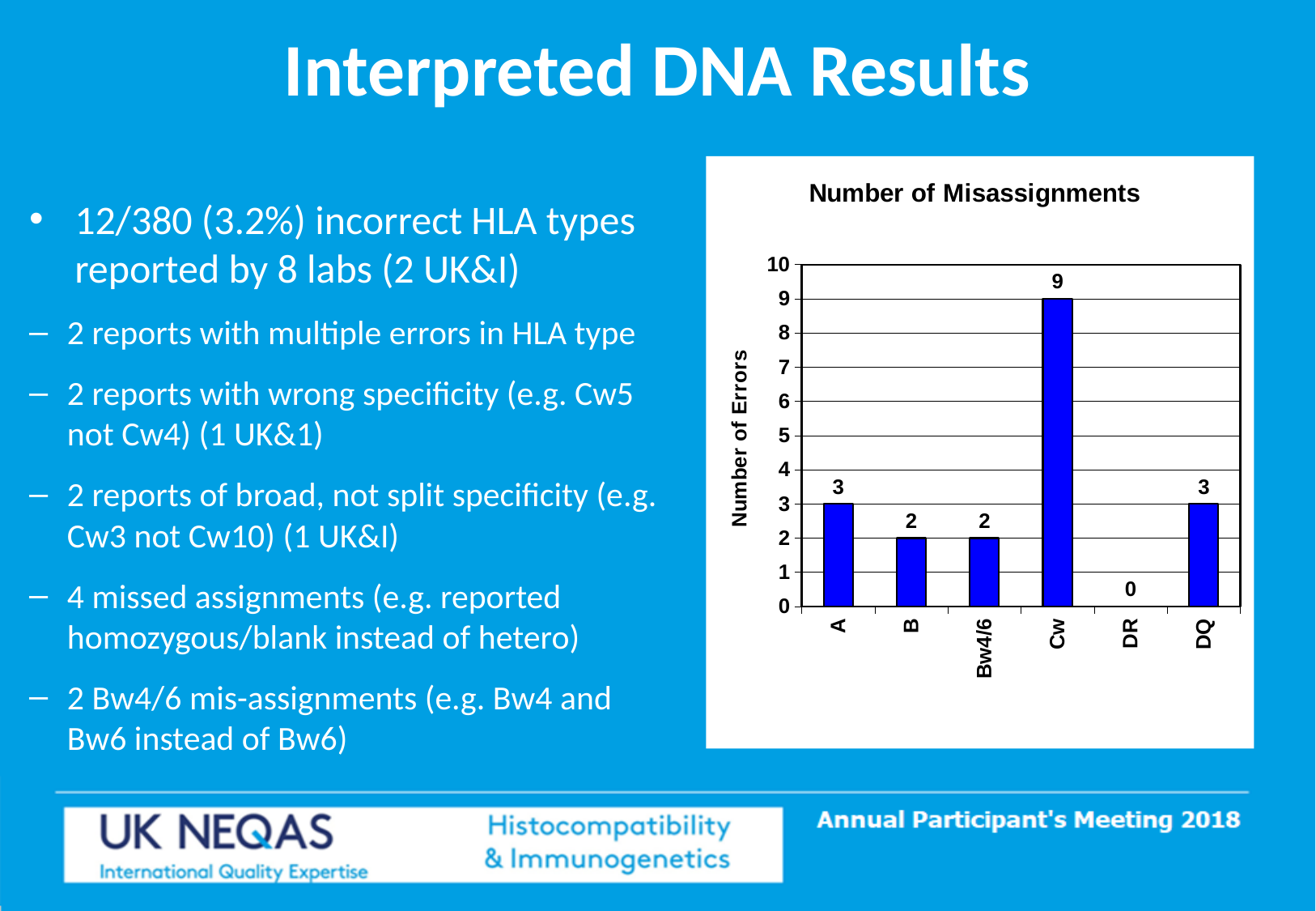
Which has more errors, B or A? A Which category has the lowest number of misassignments? DR What is the number of errors for A? 3 Which category has the highest number of misassignments? Cw What is the difference in number of errors between Cw and DQ? 6 How many categories are shown on the x axis of the chart? 6 What is the number of errors for DR? 0 What kind of chart is shown on the slide? Bar chart What is the title of the chart? Number of Misassignments What is the number of errors for Cw? 9 What is the number of errors for Bw4/6? 2 Is the value for Cw greater or less than 5? greater